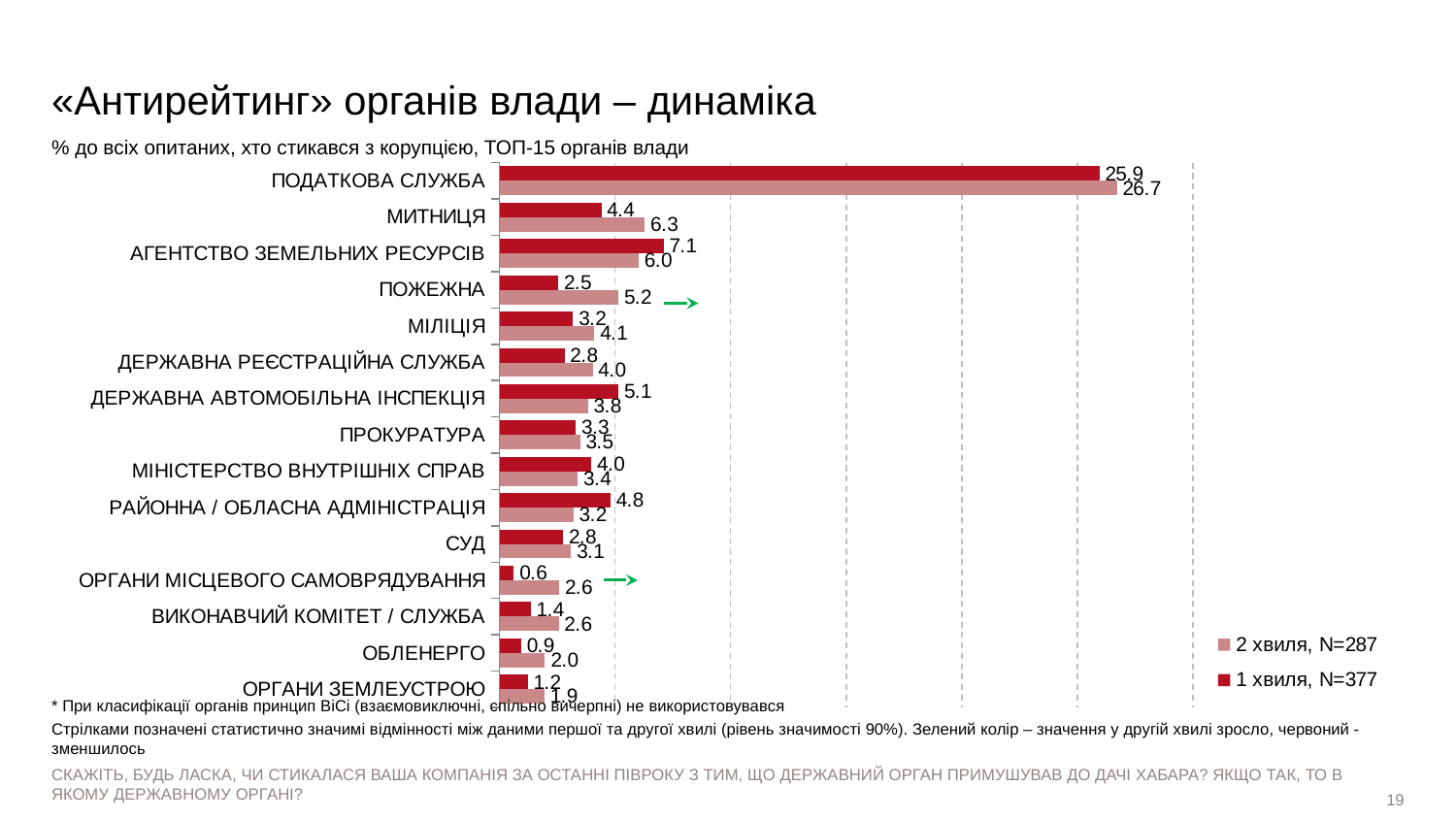
How many government bodies (categories) are shown in the chart? 15 Which category has the highest value in the series '1 хвиля, N=377'? ПОДАТКОВА СЛУЖБА For АГЕНТСТВО ЗЕМЕЛЬНИХ РЕСУРСІВ, which series has the larger value: '1 хвиля, N=377' or '2 хвиля, N=287'? 1 хвиля, N=377 What is the value for ПОЖЕЖНА in the series '2 хвиля, N=287'? 5.2 What is the sample size (N) shown in the legend for the series '2 хвиля'? N=287 What is the difference between the '2 хвиля, N=287' and '1 хвиля, N=377' values for ПОЖЕЖНА? 2.7 What type of chart is shown on the slide? bar chart What is the value for ПОДАТКОВА СЛУЖБА in the series '2 хвиля, N=287'? 26.7 What is the value for МИТНИЦЯ in the series '1 хвиля, N=377'? 4.4 What is the difference between the '1 хвиля, N=377' and '2 хвиля, N=287' values for РАЙОННА / ОБЛАСНА АДМІНІСТРАЦІЯ? 1.6 How many series does the legend list? 2 Which category has the lowest value in the series '1 хвиля, N=377'? ОРГАНИ МІСЦЕВОГО САМОВРЯДУВАННЯ